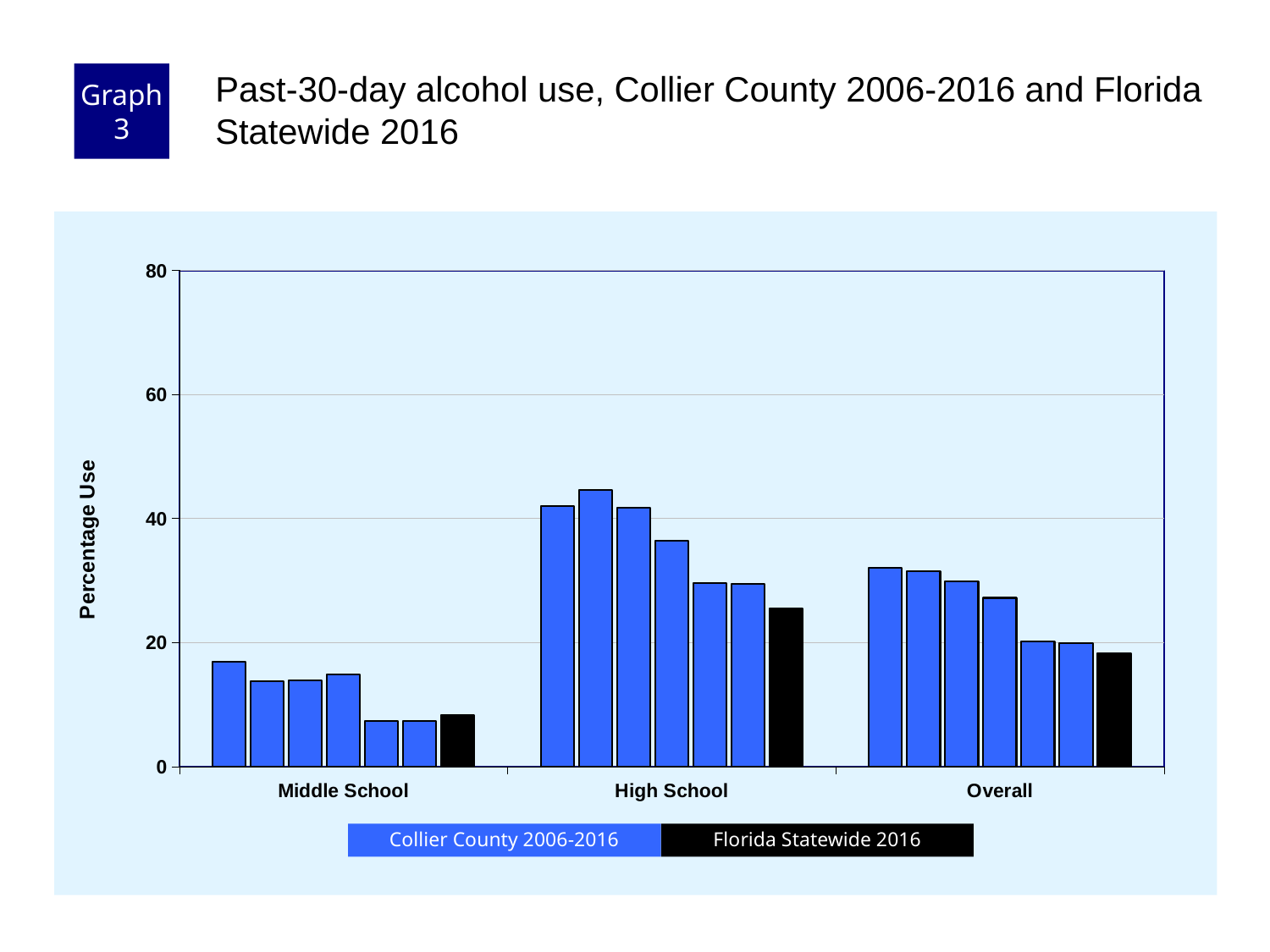
Which category has the highest bars overall? High School What kind of chart is shown on the slide? Bar chart Are all the Collier County 2006-2016 bars for Middle School greater or less than 20? less Is the tallest Collier County 2006-2016 bar for High School greater or less than 40? greater How many categories are shown on the x axis? 3 How many series does the legend list? 2 Which is larger, the Florida Statewide 2016 value for High School or for Middle School? High School Is the Florida Statewide 2016 value for Middle School greater or less than 20? less What is the label on the y axis? Percentage Use Which category has the lowest bars overall? Middle School Within the Overall category, do the Collier County 2006-2016 bars rise or fall from left to right? fall